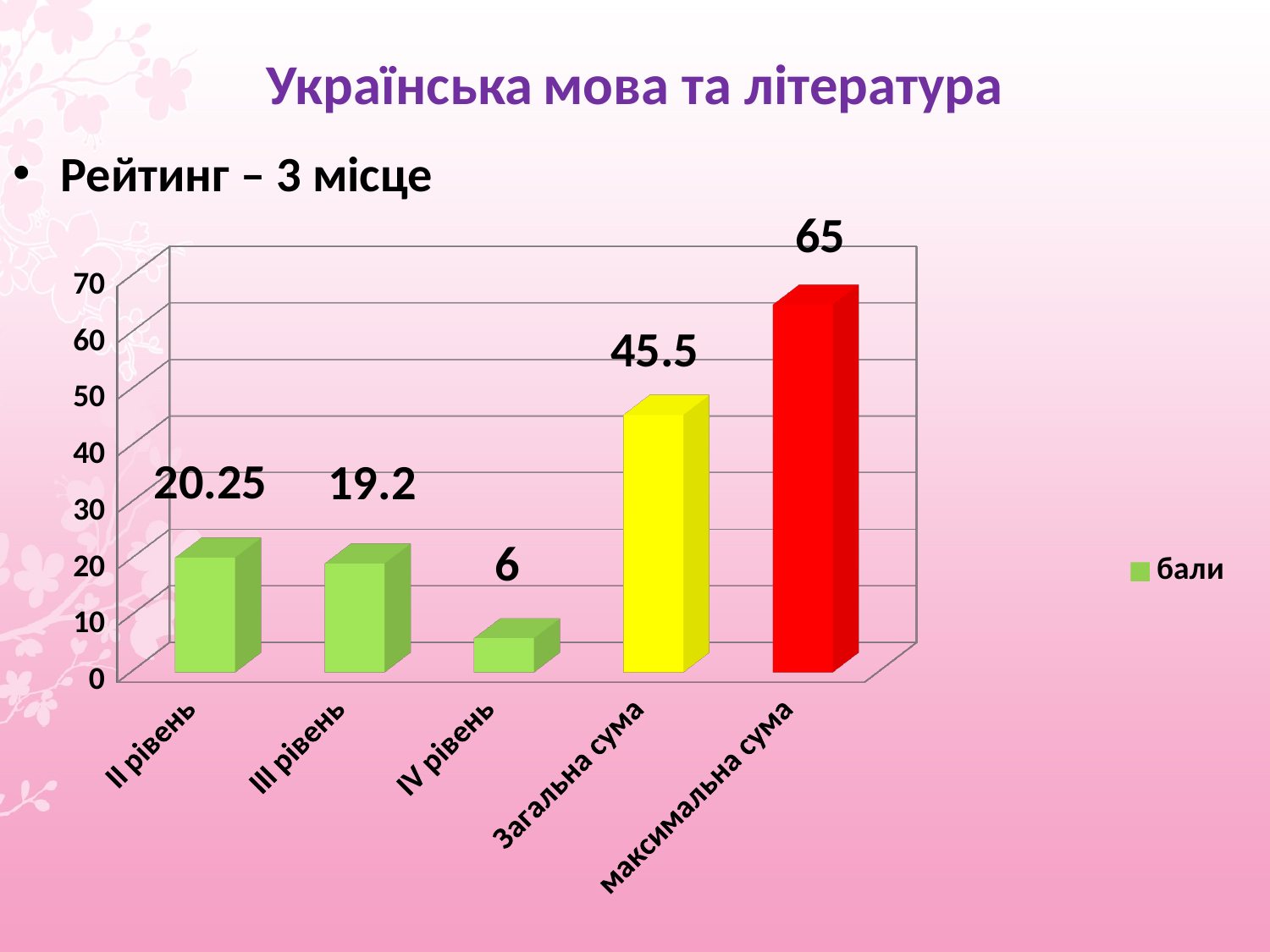
What kind of chart is shown on the slide? bar chart What is the value for IV рівень? 6 Which is larger, the value for Загальна сума or the value for ІІ рівень? Загальна сума Which category has the highest value? максимальна сума Which category has the lowest value? IV рівень What is the value for Загальна сума? 45.5 What series name does the legend list? бали What is the value for ІІ рівень? 20.25 What is the value for ІІІ рівень? 19.2 How many categories are shown on the x axis? 5 What is the difference between ІІ рівень and ІІІ рівень? 1.05 What is the difference between максимальна сума and Загальна сума? 19.5